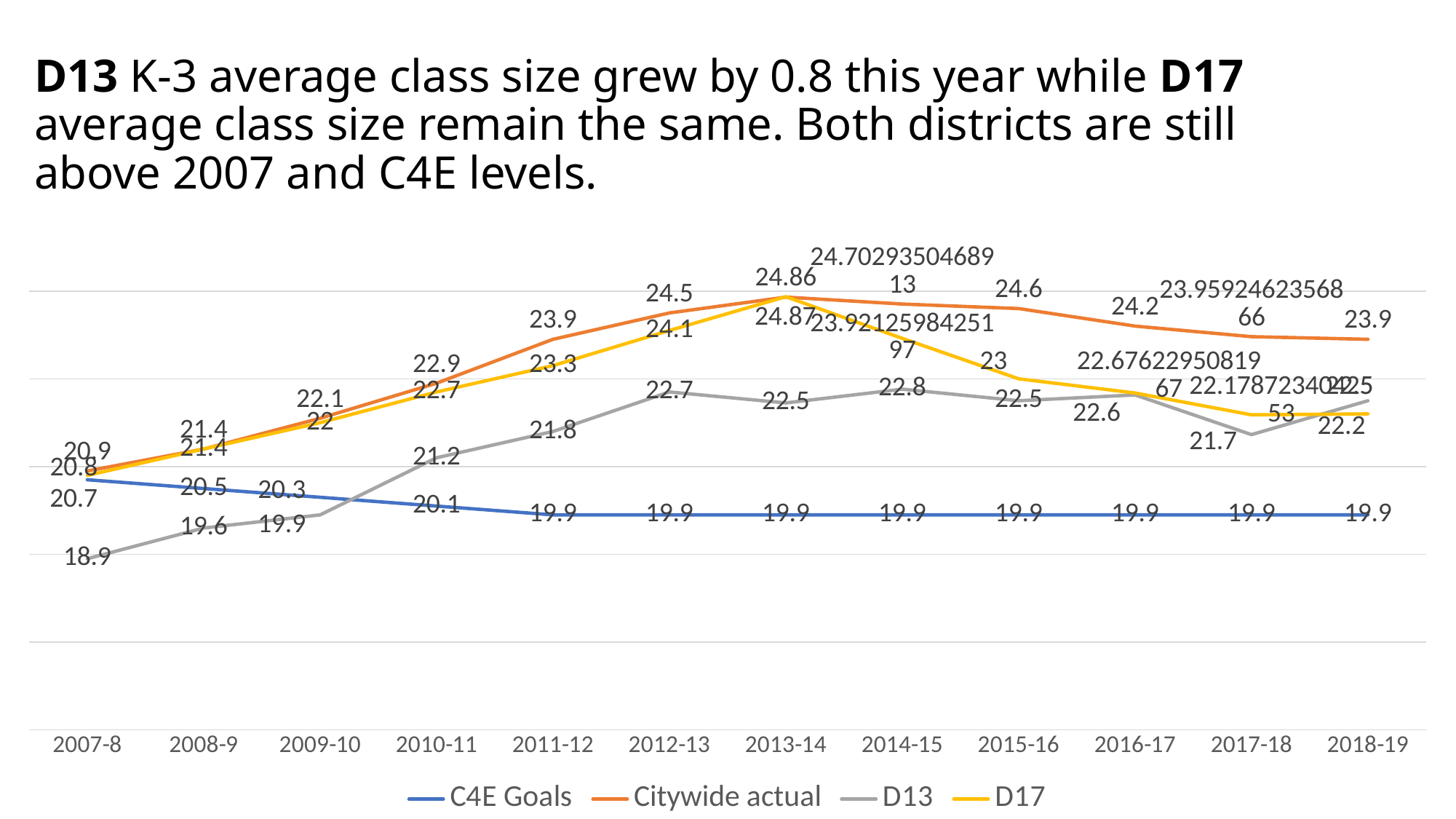
How many school years are shown along the x axis? 12 What is the D13 value for 2017-18? 21.7 In which year is the Citywide actual value highest? 2013-14 In which year is the D13 value lowest? 2007-8 What is the D13 value for 2007-8? 18.9 What is the difference between the Citywide actual value and the C4E Goals value in 2018-19? 4.0 What kind of chart is shown on the slide? line chart What is the D17 value for 2011-12? 23.3 In 2012-13, which is larger: Citywide actual or D17? Citywide actual What is the Citywide actual value for 2018-19? 23.9 What is the C4E Goals value for 2007-8? 20.7 How many series does the legend list? 4